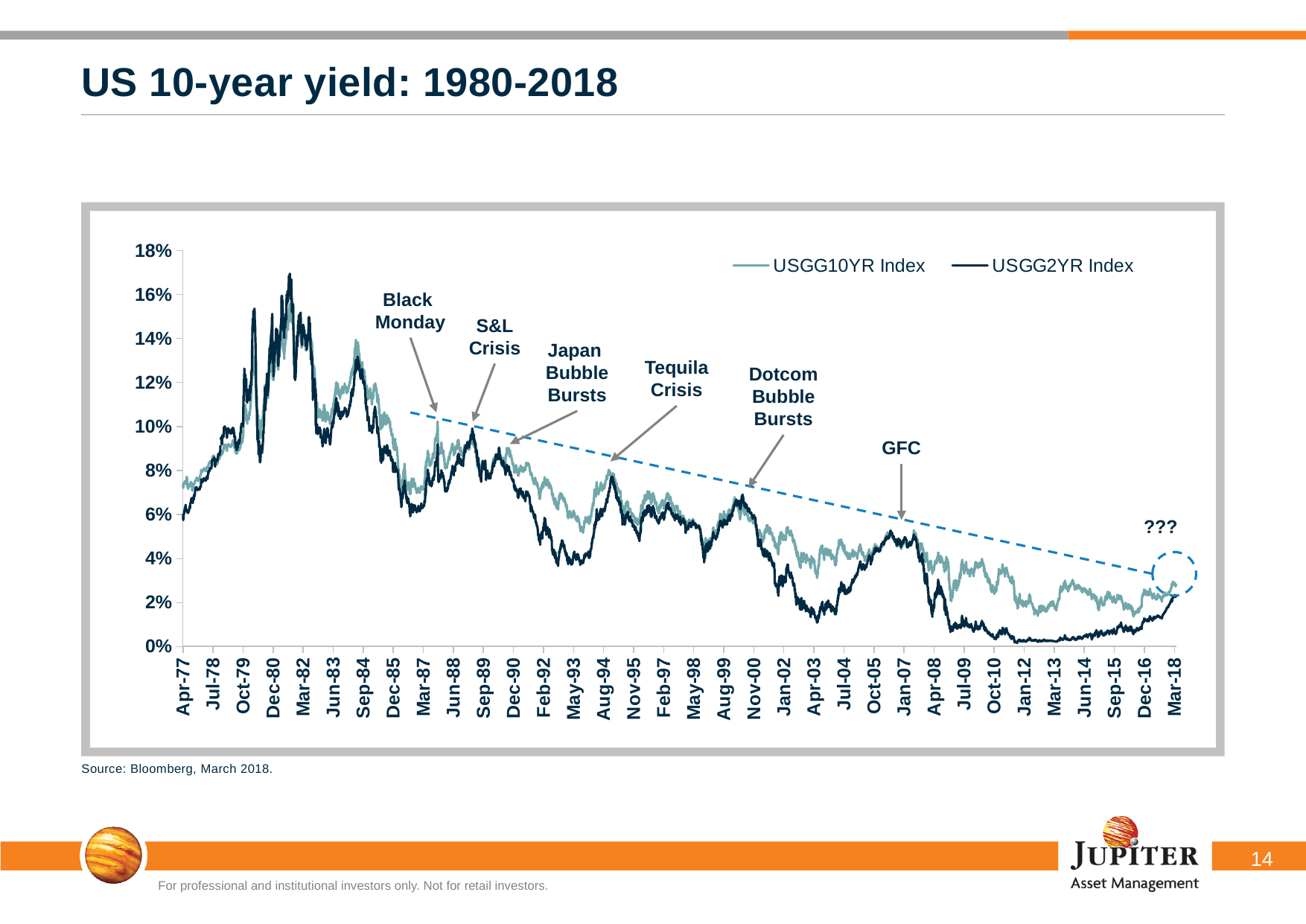
What is the title of the slide containing the chart? US 10-year yield: 1980-2018 What kind of chart is shown on the slide? Line chart What are the two series named in the legend? USGG10YR Index and USGG2YR Index Overall, do the yields rise or fall along the x axis from the early 1980s to 2018? Fall Is the value of the USGG10YR Index around Mar-18 greater or less than 4%? less Is the value of the USGG2YR Index around Jan-12 greater or less than 2%? less How many series does the legend list? 2 Which series reaches the higher peak in the early 1980s, USGG10YR Index or USGG2YR Index? USGG2YR Index What is the highest value shown on the y axis? 18% Is the value of the USGG2YR Index around Apr-77 greater or less than 8%? less